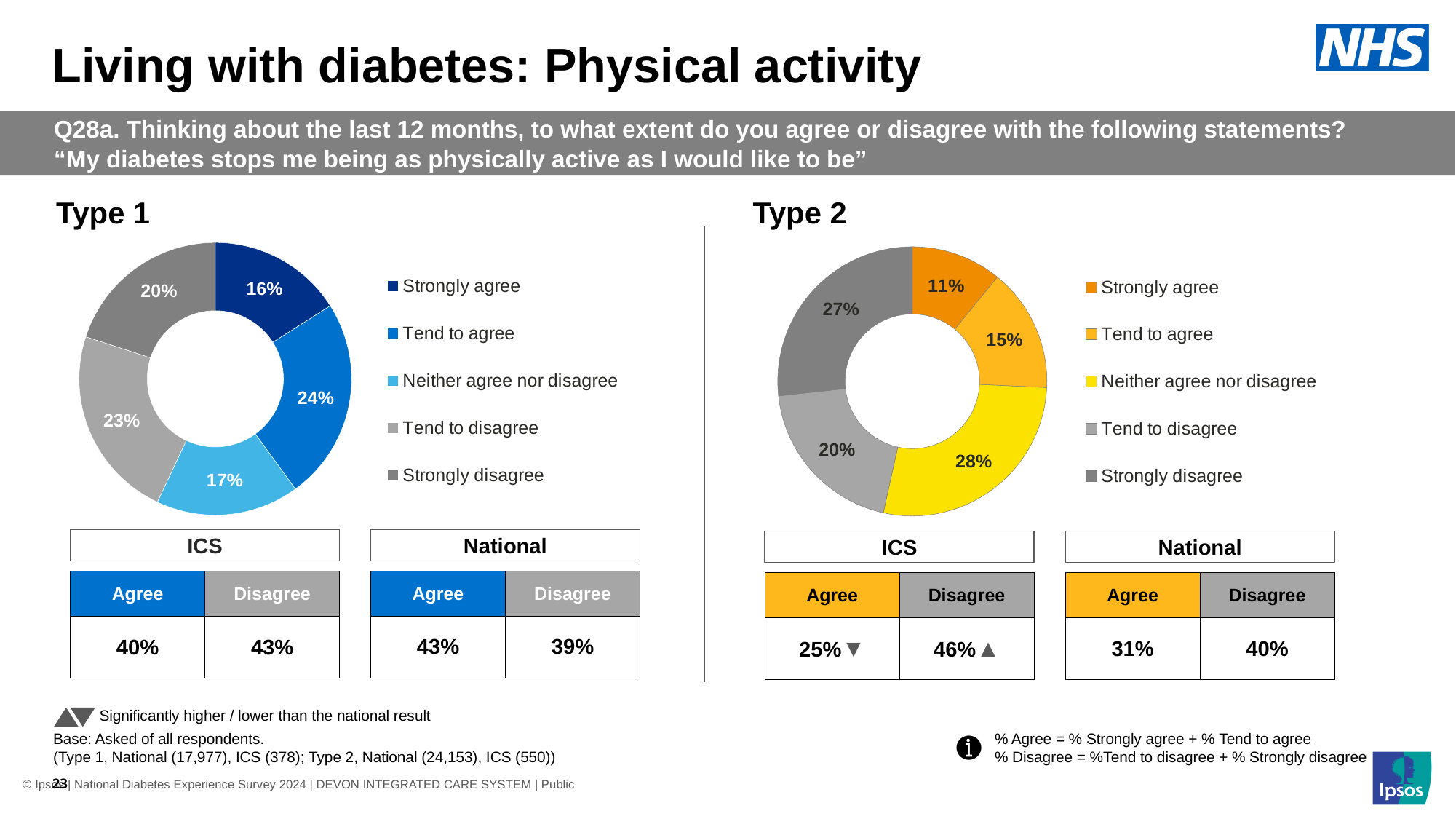
In the Type 2 chart, which response category has the smallest share? Strongly agree In the Type 1 chart, what percentage of respondents said 'Strongly agree'? 16% In the Type 1 chart, which response category has the smallest share? Strongly agree In the Type 2 chart, what percentage of respondents said 'Strongly agree'? 11% In the Type 1 chart, which is larger: 'Tend to agree' or 'Neither agree nor disagree'? Tend to agree In the Type 1 chart, which response category has the largest share? Tend to agree How many response categories does the Type 2 chart show? 5 What type of chart is used for the Type 1 results? Doughnut (pie) chart In the Type 2 chart, what is the difference between the 'Strongly disagree' and 'Tend to disagree' shares? 7 percentage points In the Type 1 chart, what percentage of respondents said 'Tend to disagree'? 23% In the Type 2 chart, what colour represents 'Neither agree nor disagree'? Yellow In the Type 2 chart, what percentage of respondents said 'Neither agree nor disagree'? 28%